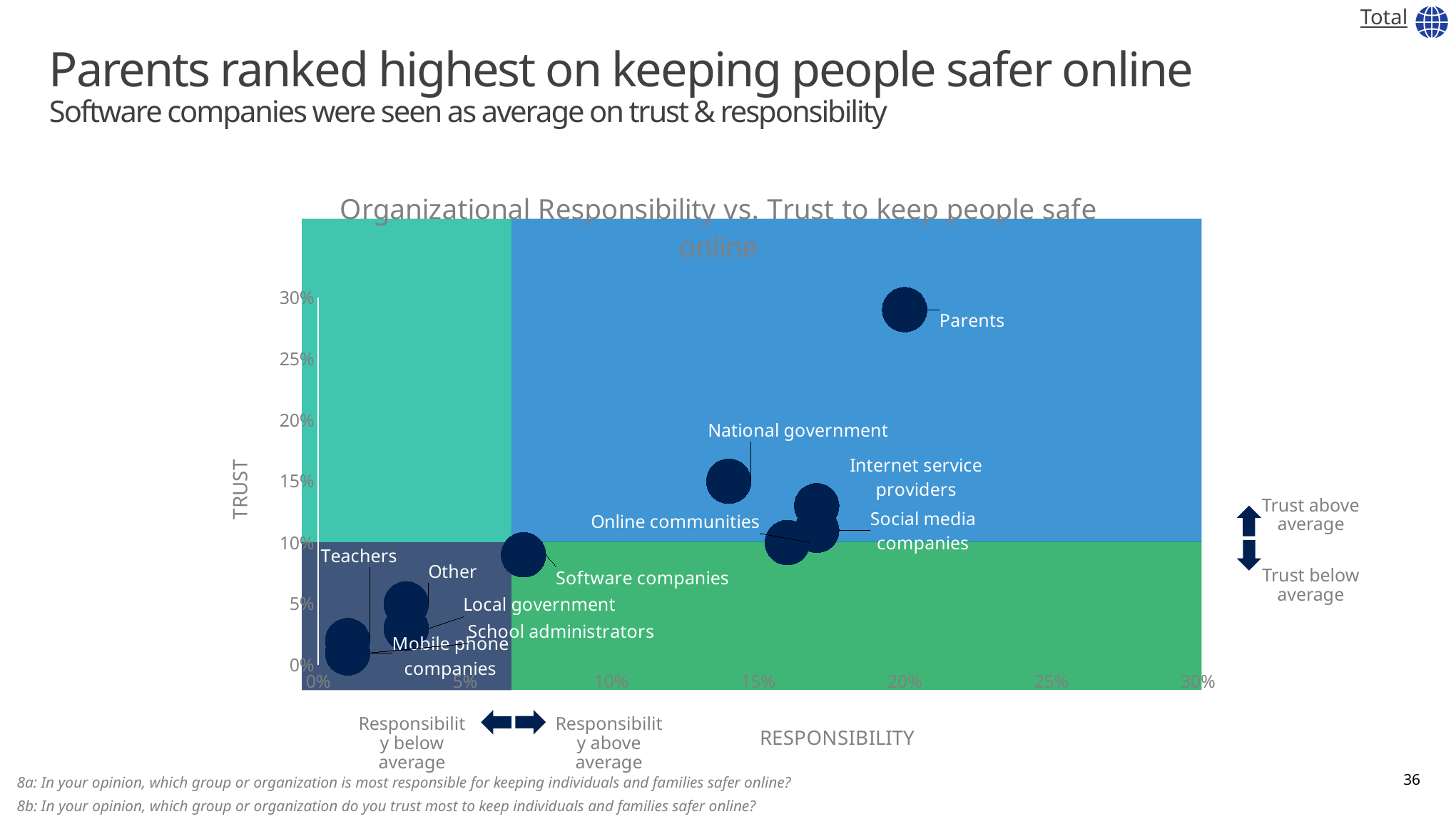
Is the trust value for Teachers greater or less than 5%? less Which has a higher trust value, Parents or National government? Parents Is the responsibility value for Parents greater or less than 15%? greater How many labeled organizations are plotted in the chart? 11 Is the trust value for National government greater or less than 20%? less Which organization has the highest responsibility value in the chart? Parents What is the title of the chart? Organizational Responsibility vs. Trust to keep people safe online What kind of chart is shown on the slide? Scatter chart Which has a higher responsibility value, National government or Software companies? National government Which organization has the highest trust value in the chart? Parents